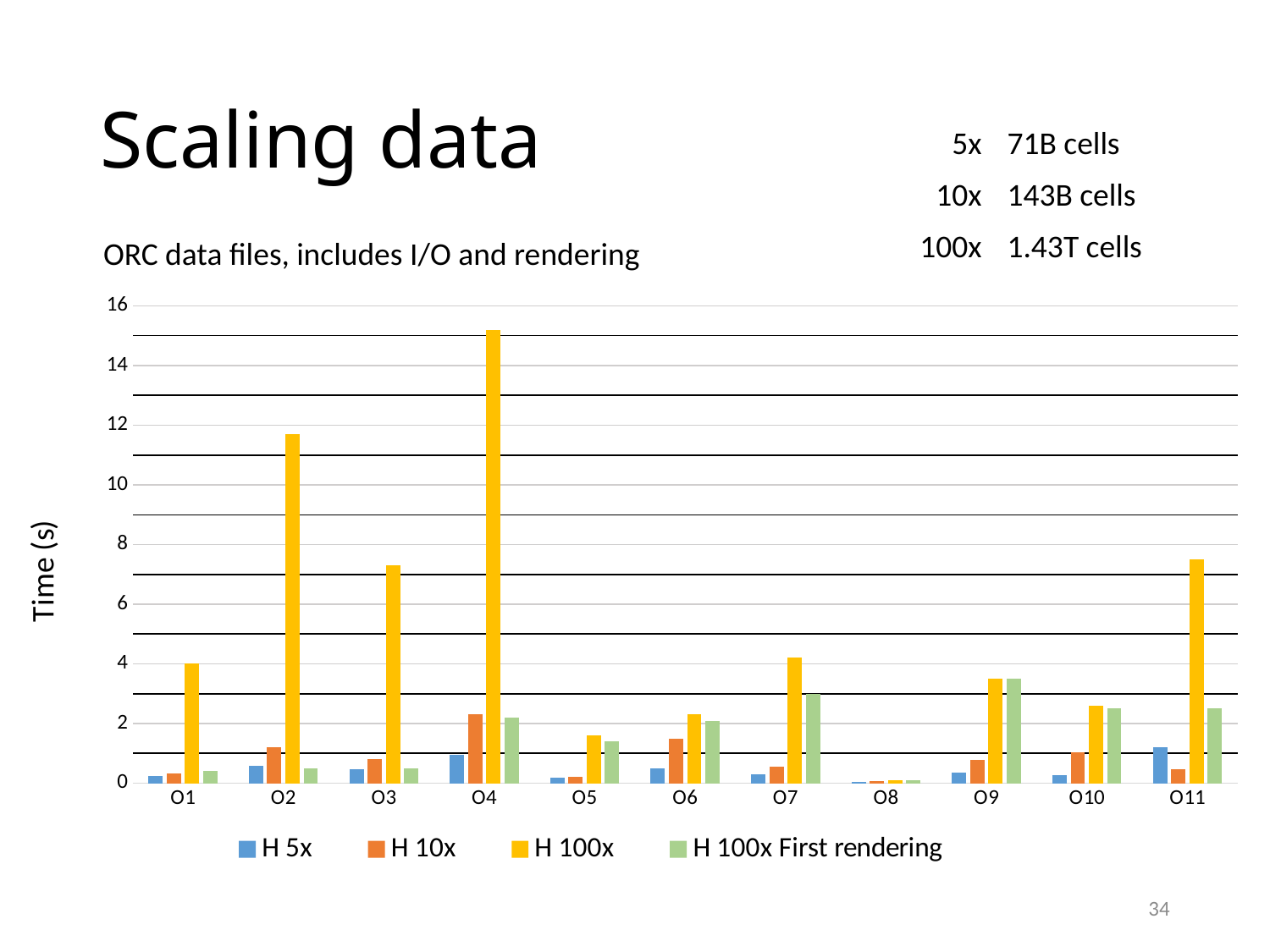
Is the H 100x value for O1 greater or less than 6? less For which category is the H 100x value highest? O4 Which has the larger H 100x value, O2 or O3? O2 For which category is the H 100x value lowest? O8 For O4, which is larger, the H 5x value or the H 10x value? H 10x What kind of chart is shown on the slide? bar chart What is the label on the vertical axis of the chart? Time (s) Is the H 100x value for O2 greater or less than 10? greater How many series does the chart legend list? 4 Is the H 100x value for O4 greater or less than 14? greater For which category is the H 10x value highest? O4 How many categories are shown on the x axis of the chart? 11